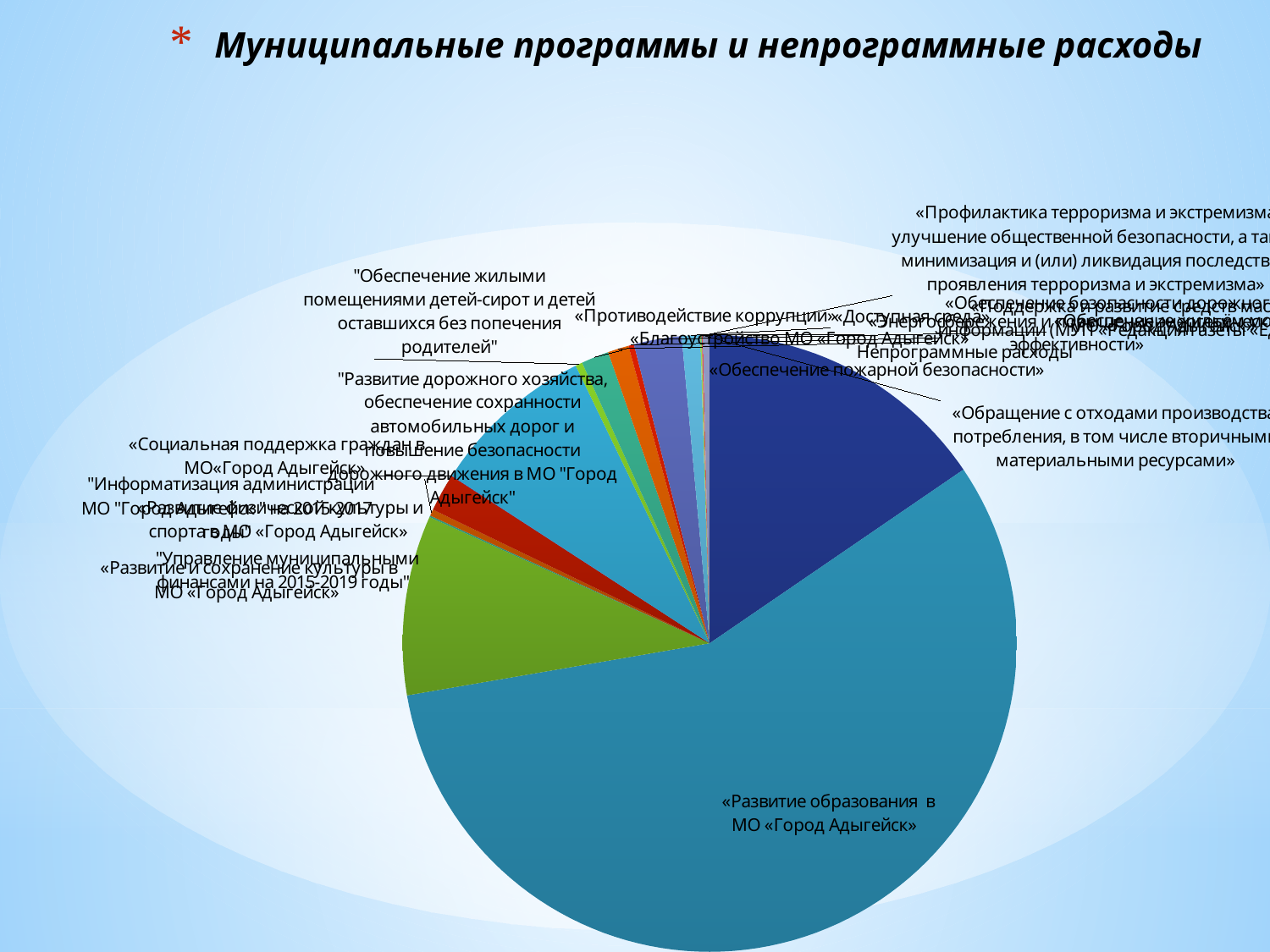
Which slice is larger: «Развитие образования в МО «Город Адыгейск» or «Обращение с отходами производства и потребления, в том числе вторичными материальными ресурсами»? «Развитие образования в МО «Город Адыгейск» What is the title of the chart on the slide? Муниципальные программы и непрограммные расходы Does the slice for «Развитие образования в МО «Город Адыгейск» take up more or less than half of the pie? more What kind of chart is shown on the slide? pie chart What colour is the largest slice of the pie? blue Which category has the largest slice of the pie? «Развитие образования в МО «Город Адыгейск»